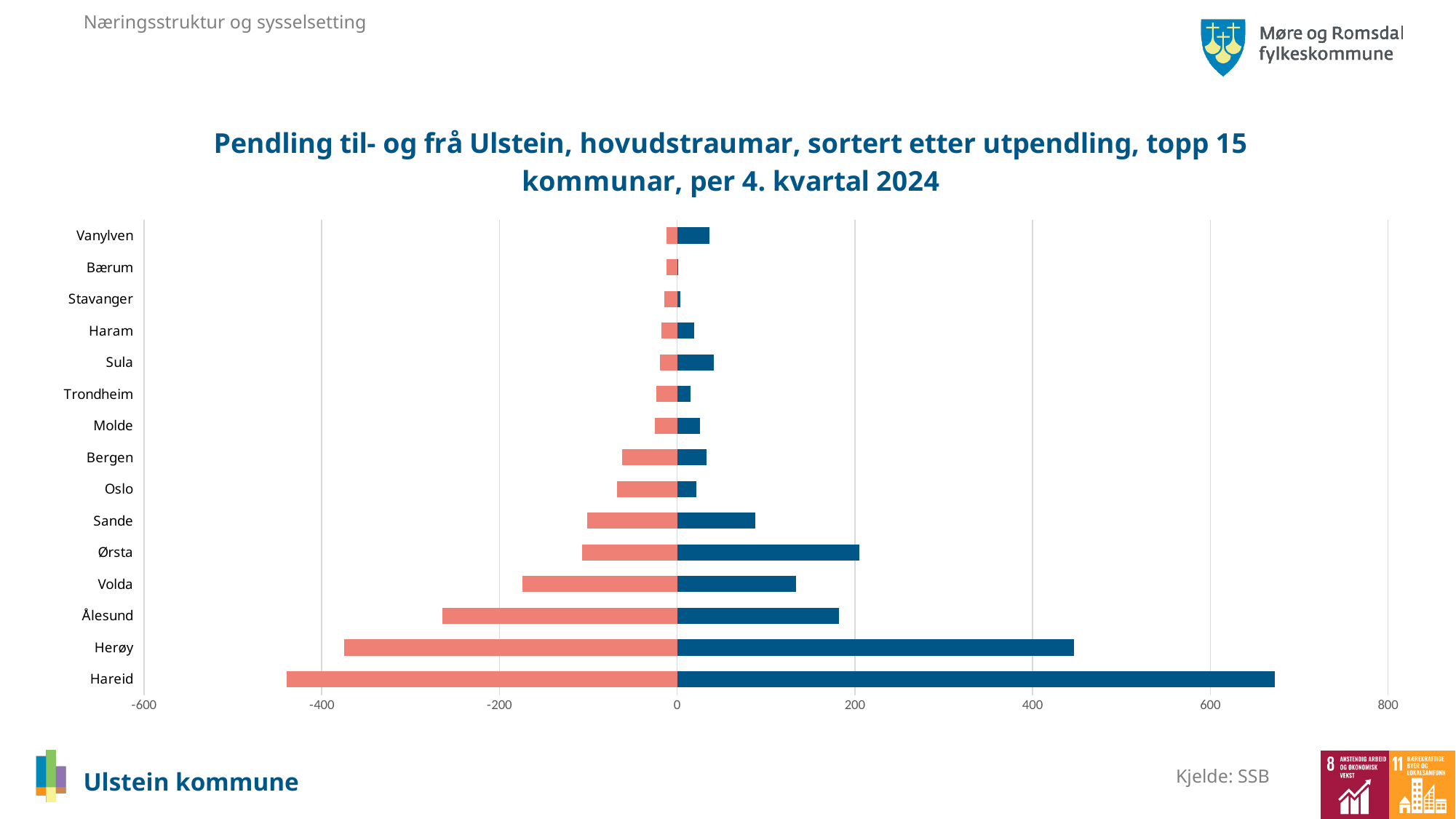
What kind of chart is shown on the slide? bar chart Which municipality is listed at the top of the chart? Vanylven Is the blue bar value for Volda greater or less than 200? less What is the source cited for the chart data? SSB Is the red bar value for Ålesund greater or less than -200? less Which municipality has the longest blue bar (largest positive value)? Hareid Is the blue bar value for Hareid greater or less than 600? greater How many municipalities (categories) are shown on the chart? 15 Which has the larger blue bar, Herøy or Ålesund? Herøy Which municipality has the longest red bar (most negative value)? Hareid